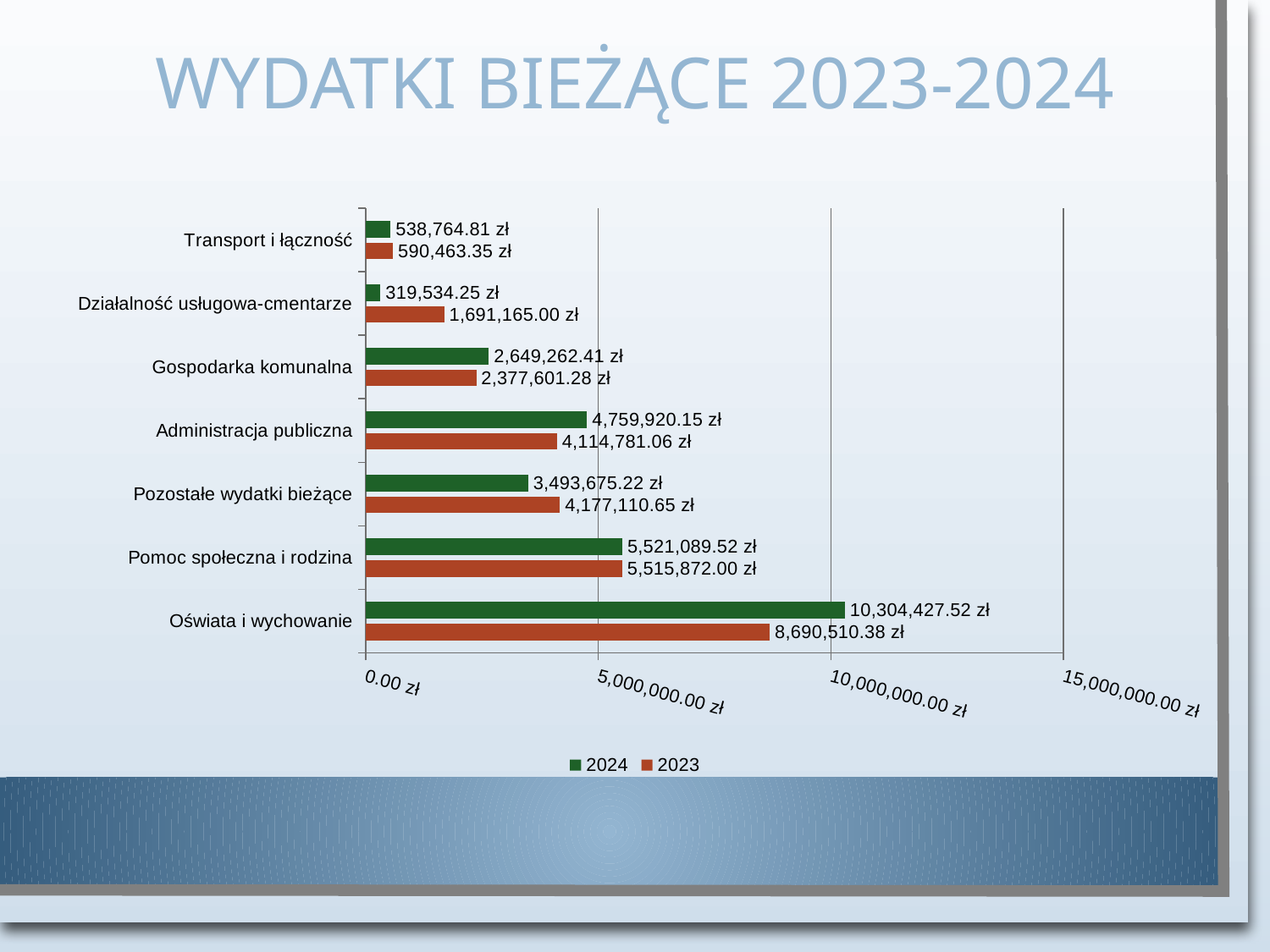
Which category has the lowest 2023 value? Transport i łączność Which category has the highest 2024 value? Oświata i wychowanie What is the 2023 value for Pozostałe wydatki bieżące? 4,177,110.65 zł What is the 2024 value for Oświata i wychowanie? 10,304,427.52 zł What is the difference between the 2024 and 2023 values for Oświata i wychowanie? 1,613,917.14 zł Which category has the lowest 2024 value? Działalność usługowa-cmentarze Is the 2024 value for Oświata i wychowanie greater or less than 10,000,000.00 zł? greater What is the difference between the 2023 and 2024 values for Działalność usługowa-cmentarze? 1,371,630.75 zł For Administracja publiczna, which year has the larger value, 2024 or 2023? 2024 What type of chart is shown on the slide? bar chart What is the 2023 value for Działalność usługowa-cmentarze? 1,691,165.00 zł How many categories are shown on the chart? 7